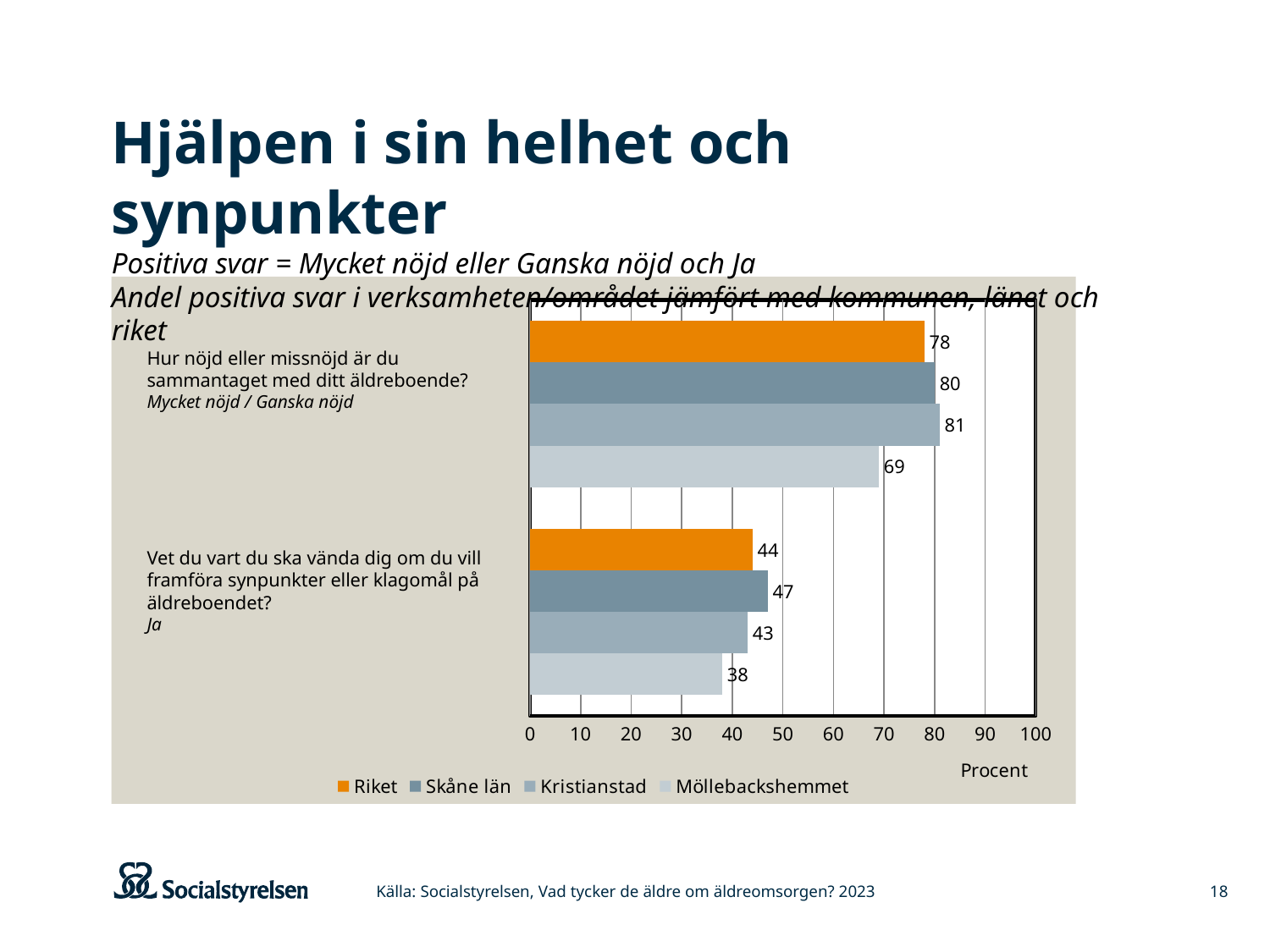
What is the value for Riket on the question about overall satisfaction with the elderly home (Hur nöjd eller missnöjd är du sammantaget med ditt äldreboende?)? 78 How many series does the legend list? 4 What is the value for Möllebackshemmet on the question about overall satisfaction with the elderly home? 69 What is the difference between Skåne län and Kristianstad on the question about knowing where to turn with complaints? 4 What is the value for Skåne län on the question about knowing where to turn with complaints (Vet du vart du ska vända dig...)? 47 What unit label is shown on the x axis of the chart? Procent Which is larger on the question about knowing where to turn with complaints: Riket or Möllebackshemmet? Riket What is the difference between Kristianstad and Möllebackshemmet on the question about overall satisfaction with the elderly home? 12 Which series has the highest value on the question about overall satisfaction with the elderly home? Kristianstad What is the value for Möllebackshemmet on the question about knowing where to turn with complaints? 38 What kind of chart is shown on the slide? bar chart Which series has the lowest value on the question about knowing where to turn with complaints? Möllebackshemmet